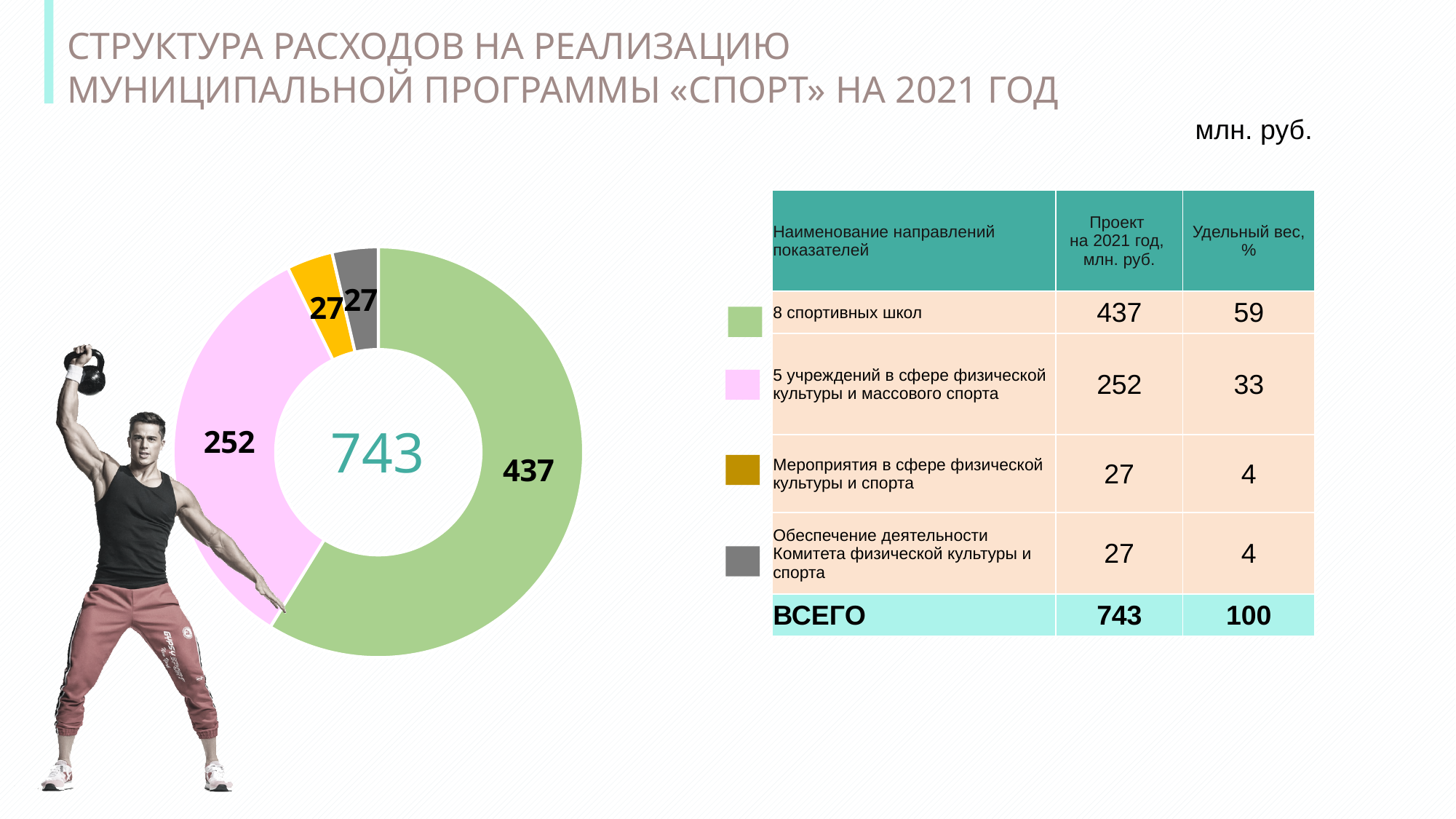
What share of the total does «8 спортивных школ» account for, according to the table? 59 What is the value for «8 спортивных школ» in the pie chart? 437 Which is larger: the value for «8 спортивных школ» or for «5 учреждений в сфере физической культуры и массового спорта»? 8 спортивных школ How many slices does the pie chart have? 4 What share of the total does «5 учреждений в сфере физической культуры и массового спорта» account for, according to the table? 33 What kind of chart is shown on the slide? doughnut chart What colour is the slice for «8 спортивных школ» in the pie chart? green Which category has the largest slice in the pie chart? 8 спортивных школ What is the difference between the values for «8 спортивных школ» and «5 учреждений в сфере физической культуры и массового спорта»? 185 What is the total shown in the centre of the pie chart? 743 What is the value for «Мероприятия в сфере физической культуры и спорта»? 27 What is the value for «5 учреждений в сфере физической культуры и массового спорта»? 252